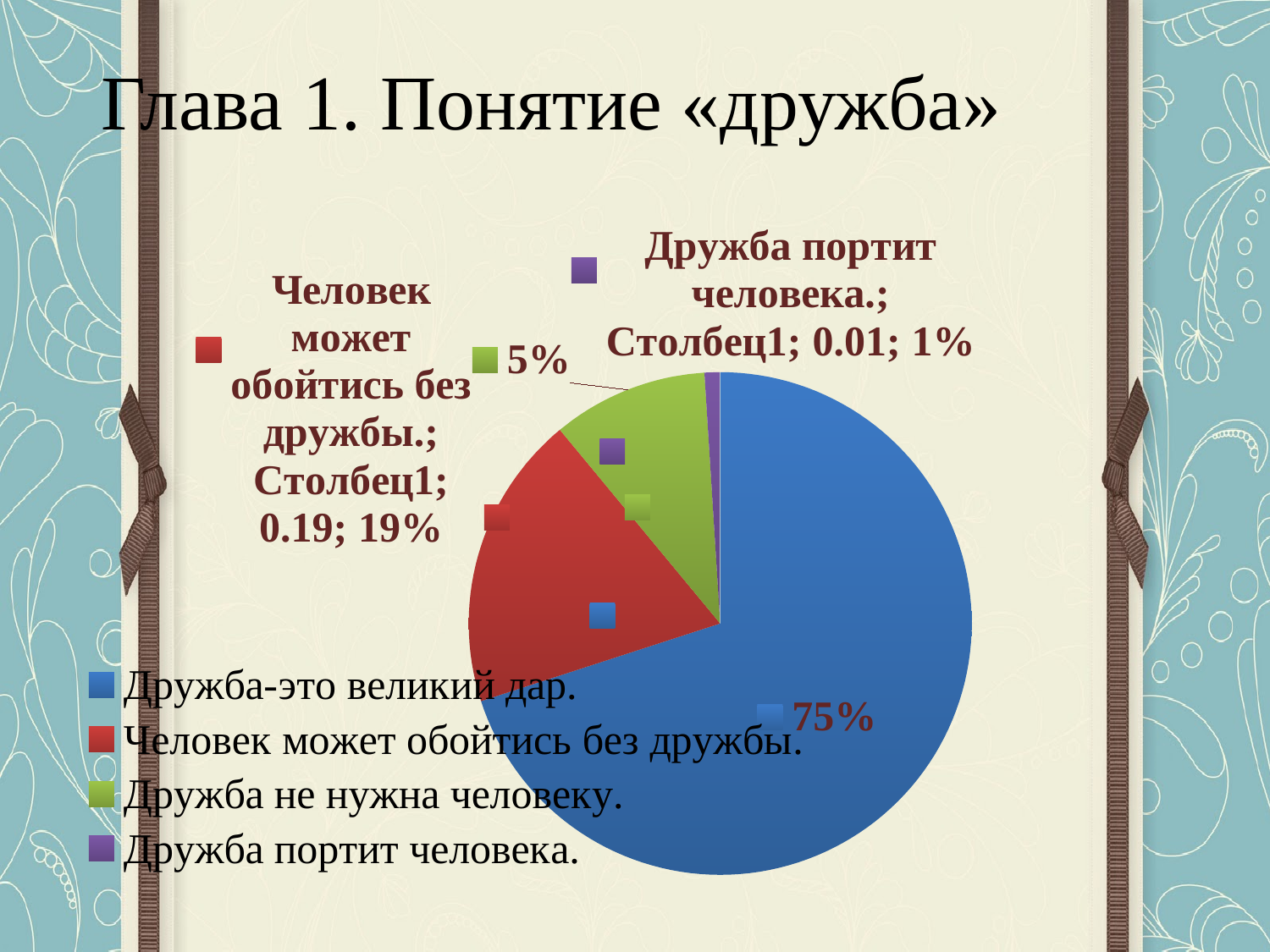
What share of the pie does "Дружба не нужна человеку." have? 5% Which is larger: the slice for "Дружба не нужна человеку." or the slice for "Дружба портит человека."? Дружба не нужна человеку. What is the difference in percentage points between "Дружба-это великий дар." and "Человек может обойтись без дружбы."? 56 Which category has the largest slice of the pie? Дружба-это великий дар. What colour is the slice for "Человек может обойтись без дружбы."? red What share of the pie does "Человек может обойтись без дружбы." have? 19% How many slices does the pie chart have? 4 What share of the pie does "Дружба портит человека." have? 1% What kind of chart is shown on the slide? pie chart How many entries does the legend list? 4 Which category has the smallest slice of the pie? Дружба портит человека.